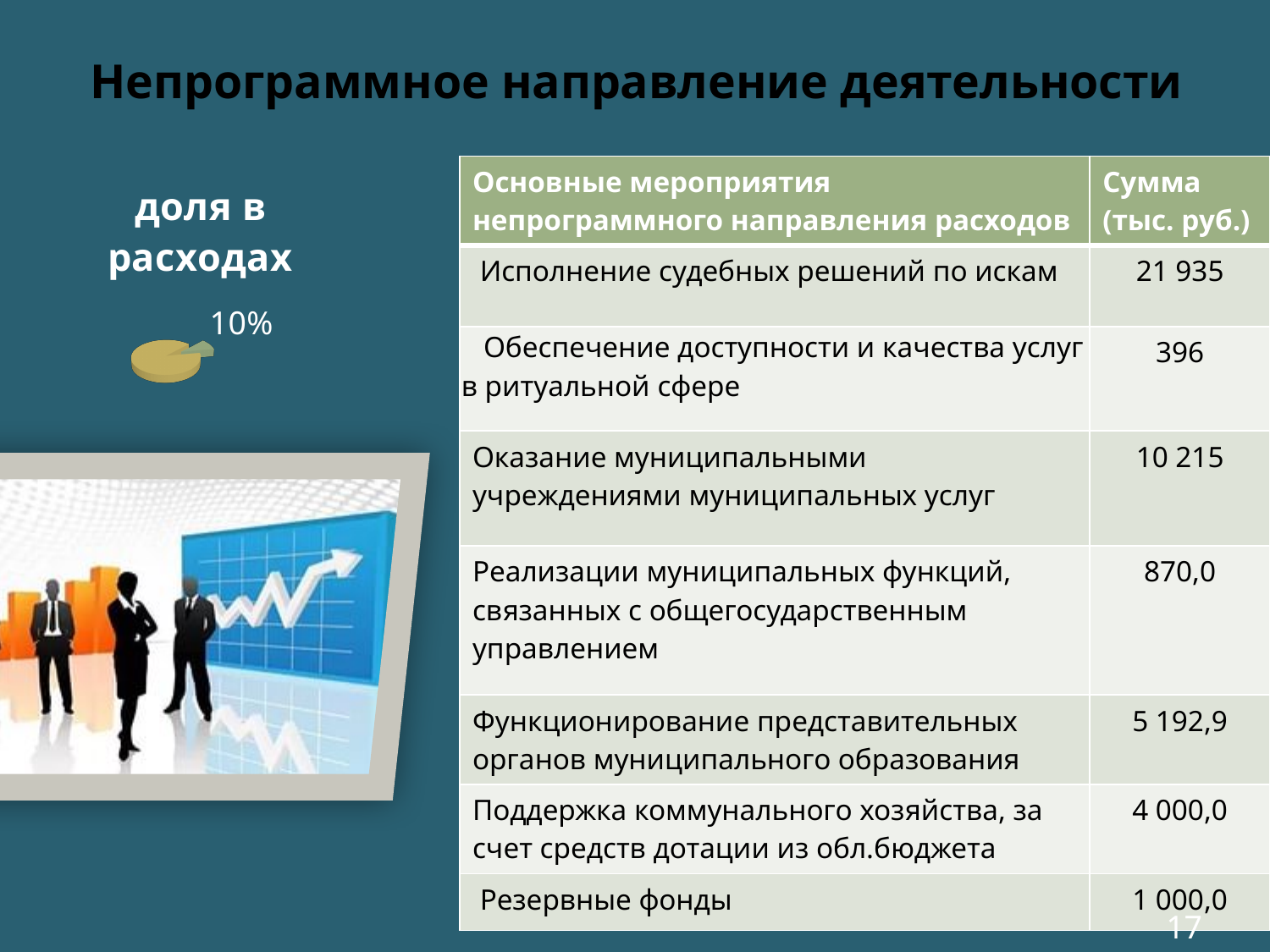
What share of the pie does the pulled-out slice represent? 10% How many slices does the pie chart show? 2 Is the labeled slice of the pie chart larger or smaller than the remaining slice? smaller What is the heading above the pie chart? доля в расходах What percentage is printed as the data label on the pie chart? 10% What kind of chart is shown under the heading "доля в расходах"? pie chart